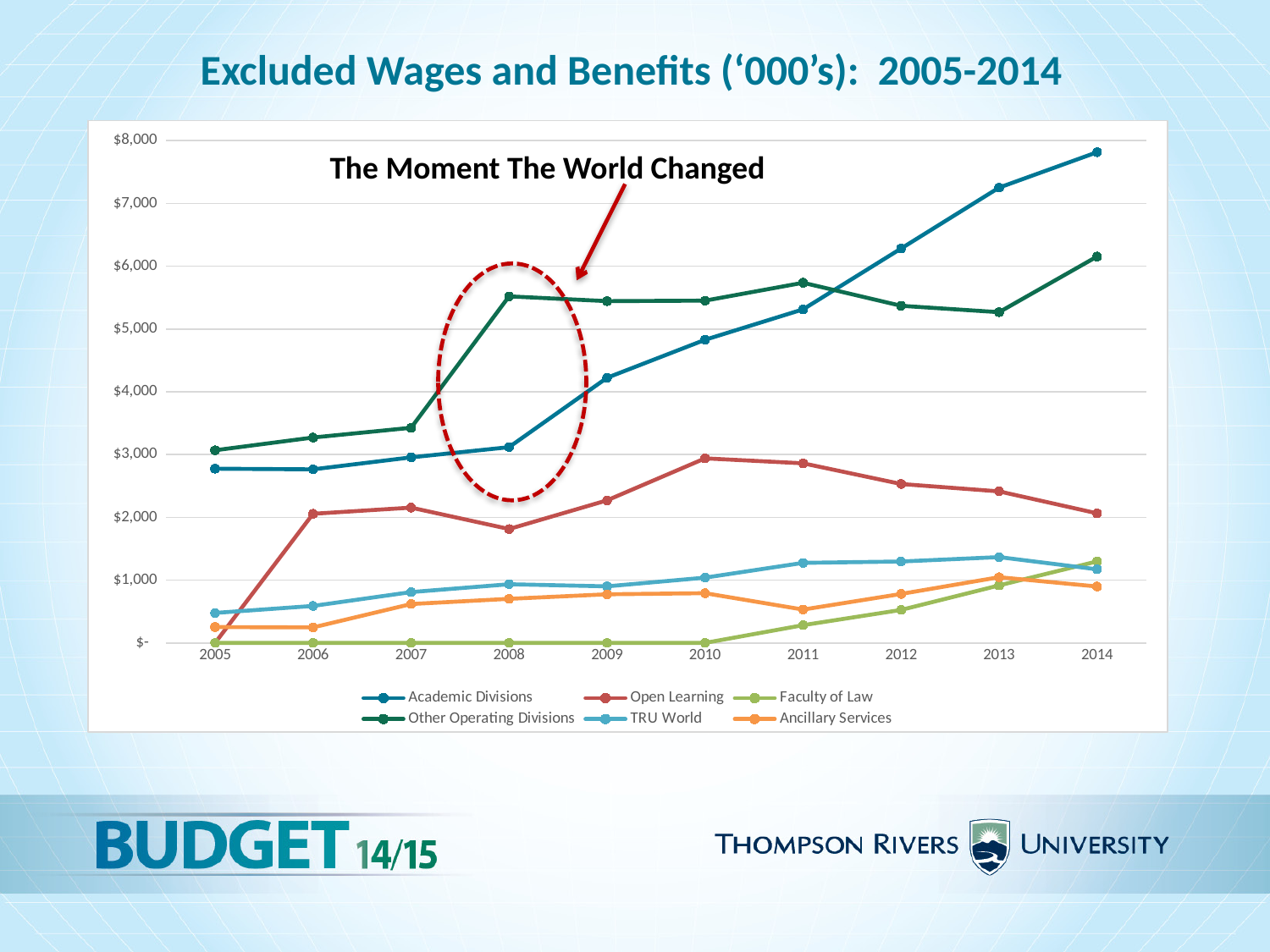
Is the value for Open Learning in 2008 greater or less than $2,000? less Is the value for Academic Divisions in 2014 greater or less than $7,000? greater How many years are plotted along the x axis? 10 How many series does the legend list? 6 Do the values for Academic Divisions rise or fall from 2005 to 2014? rise In 2010, which is larger: Other Operating Divisions or Academic Divisions? Other Operating Divisions In 2013, which is larger: TRU World or Ancillary Services? TRU World Is the value for Other Operating Divisions in 2008 greater or less than $5,000? greater What kind of chart is shown on the slide? line chart What annotation text is written above the dashed red circle on the chart? The Moment The World Changed Which series has the highest value in 2014? Academic Divisions